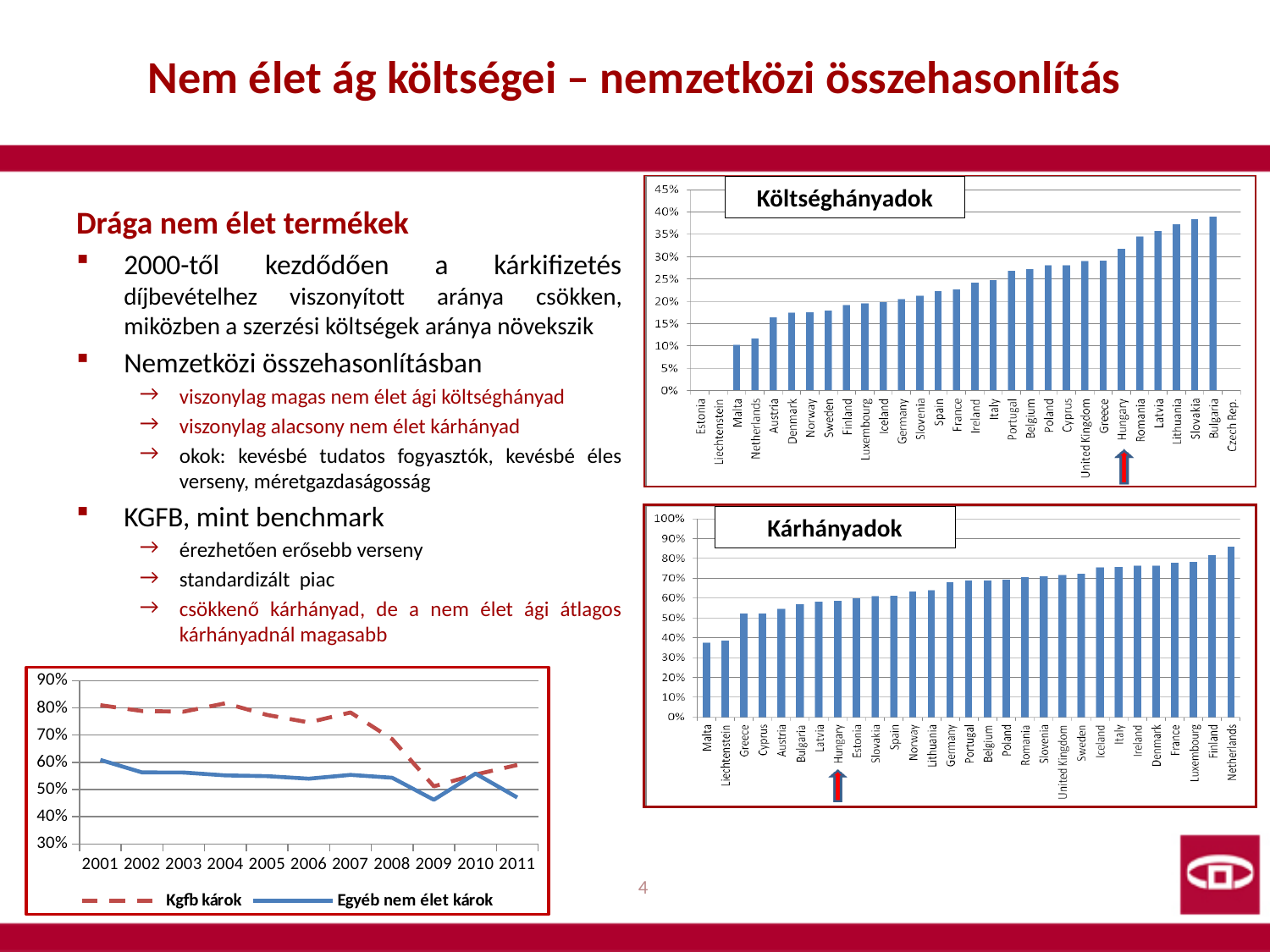
In the Költséghányadok chart, which is larger, the value for Hungary or the value for Spain? Hungary In the Kárhányadok chart, which country has the lowest claims ratio? Malta How many series does the legend of the line chart at the bottom left list? 2 In the Költséghányadok chart, which country has the highest cost ratio? Czech Rep. In the Kárhányadok chart, which country has the highest claims ratio? Netherlands In the Költséghányadok chart, is the value for Malta greater or less than 15%? less What kind of chart is the Kárhányadok chart? bar chart In the Kárhányadok chart, which is larger, the value for Finland or the value for Greece? Finland In the line chart at the bottom left, does the Kgfb károk series rise or fall from 2001 to 2011? fall In the Kárhányadok chart, is the value for Hungary greater or less than 50%? greater In the Költséghányadok chart, is the value for Hungary greater or less than 30%? greater